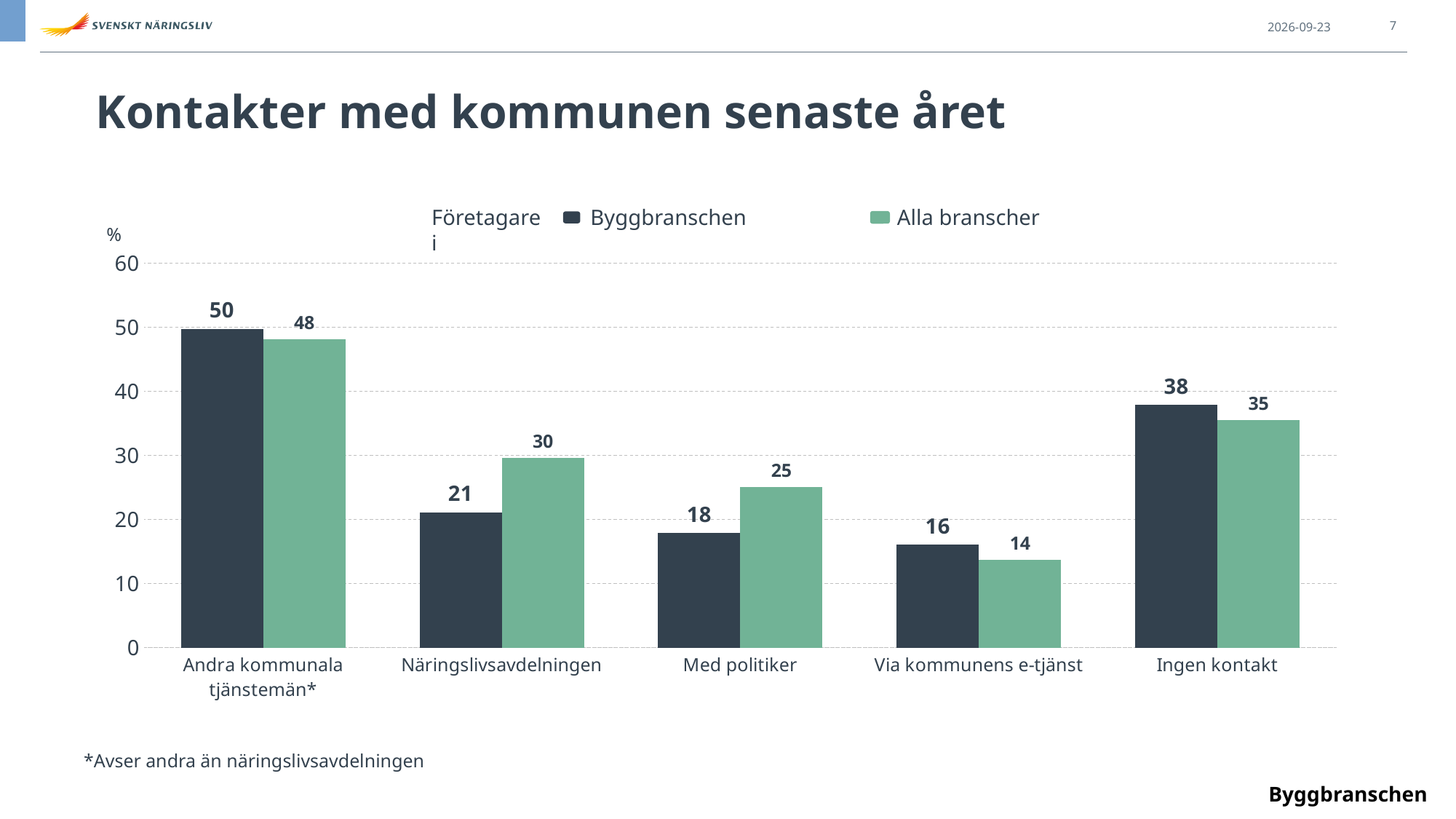
What is the value for Byggbranschen in the category Ingen kontakt? 38 In the category Näringslivsavdelningen, which series has the larger value, Byggbranschen or Alla branscher? Alla branscher What kind of chart is shown on the slide? Bar chart What is the value for Byggbranschen in the category Andra kommunala tjänstemän*? 50 Which category has the highest value for Byggbranschen? Andra kommunala tjänstemän* Which category has the lowest value for Alla branscher? Via kommunens e-tjänst What is the title of the slide? Kontakter med kommunen senaste året How many categories are shown on the x axis? 5 What is the value for Alla branscher in the category Näringslivsavdelningen? 30 What is the value for Alla branscher in the category Via kommunens e-tjänst? 14 How many series does the legend list? 2 What is the difference between Alla branscher and Byggbranschen in the category Med politiker? 7